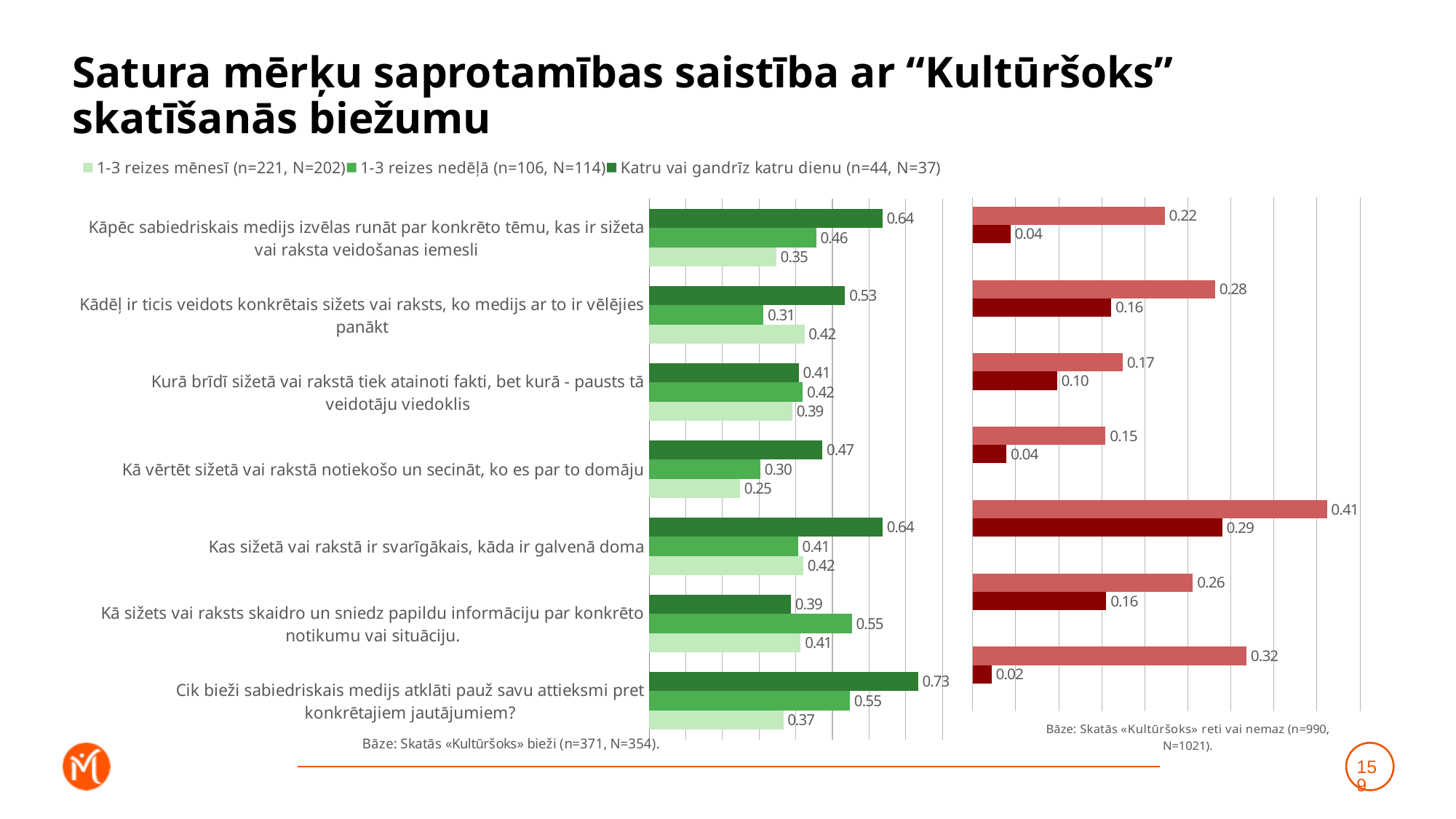
In the green chart on the left, what is the value for "1-3 reizes mēnesī" for the category "Kā vērtēt sižetā vai rakstā notiekošo un secināt, ko es par to domāju"? 0.25 In the green chart on the left, for the category "Kāpēc sabiedriskais medijs izvēlas runāt par konkrēto tēmu, kas ir sižeta vai raksta veidošanas iemesli", what is the difference between the "Katru vai gandrīz katru dienu" value and the "1-3 reizes mēnesī" value? 0.29 In the red chart on the right, what is the value of the lighter red bar for the category "Kas sižetā vai rakstā ir svarīgākais, kāda ir galvenā doma"? 0.41 In the green chart on the left, for the category "Kā sižets vai raksts skaidro un sniedz papildu informāciju par konkrēto notikumu vai situāciju.", which series has the larger value: "1-3 reizes nedēļā" or "Katru vai gandrīz katru dienu"? 1-3 reizes nedēļā How many categories are shown in the green chart on the left? 7 In the red chart on the right, which category has the highest value for the darker red bars? Kas sižetā vai rakstā ir svarīgākais, kāda ir galvenā doma According to the legend of the green chart on the left, what sample sizes are given for the "Katru vai gandrīz katru dienu" series? n=44, N=37 In the green chart on the left, which category has the highest value for the "Katru vai gandrīz katru dienu" series? Cik bieži sabiedriskais medijs atklāti pauž savu attieksmi pret konkrētajiem jautājumiem? In the green chart on the left, which category has the lowest value for the "1-3 reizes mēnesī" series? Kā vērtēt sižetā vai rakstā notiekošo un secināt, ko es par to domāju In the green chart on the left, what is the value for "Katru vai gandrīz katru dienu" for the category "Cik bieži sabiedriskais medijs atklāti pauž savu attieksmi pret konkrētajiem jautājumiem?"? 0.73 What type of chart is the green chart on the left? Bar chart How many series does the legend of the green chart on the left list? 3